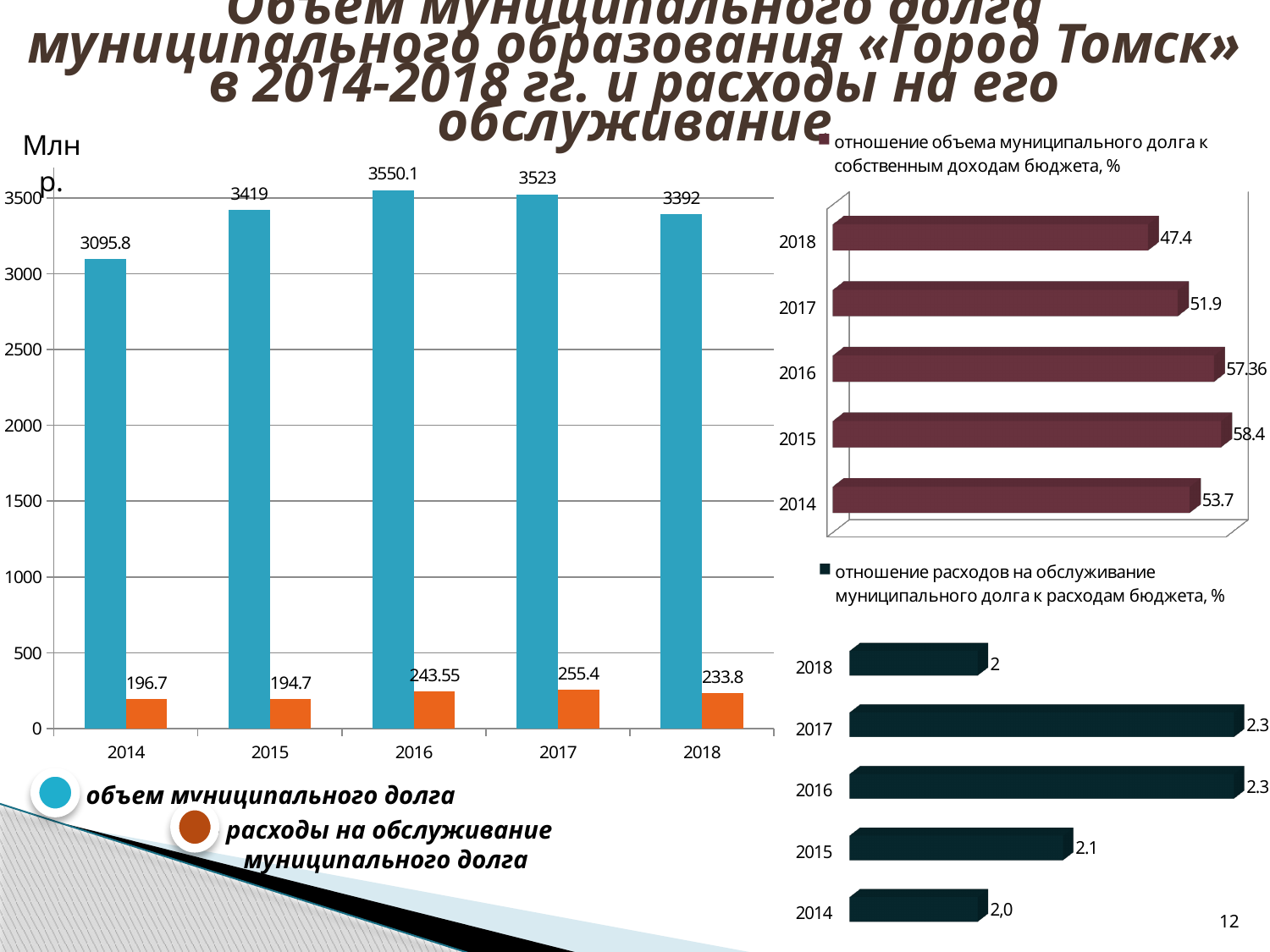
On the left bar chart, in which year is «объем муниципального долга» the highest? 2016 How many series does the legend of the left bar chart list? 2 What kind of chart is the left chart on the slide? bar chart On the bottom-right chart («отношение расходов на обслуживание муниципального долга к расходам бюджета, %»), what is the value for 2015? 2.1 On the top-right chart («отношение объема муниципального долга к собственным доходам бюджета, %»), which year has the lowest value? 2018 On the left bar chart, what is the value of «расходы на обслуживание муниципального долга» for 2017? 255.4 On the top-right chart («отношение объема муниципального долга к собственным доходам бюджета, %»), which year has the highest value? 2015 On the left bar chart, what is the value of «объем муниципального долга» for 2016? 3550.1 On the left bar chart, in which year are «расходы на обслуживание муниципального долга» the lowest? 2015 On the left bar chart, by how much did «объем муниципального долга» in 2016 exceed the value in 2014? 454.3 How many years are shown on the top-right chart («отношение объема муниципального долга к собственным доходам бюджета, %»)? 5 On the top-right chart («отношение объема муниципального долга к собственным доходам бюджета, %»), what is the value for 2015? 58.4